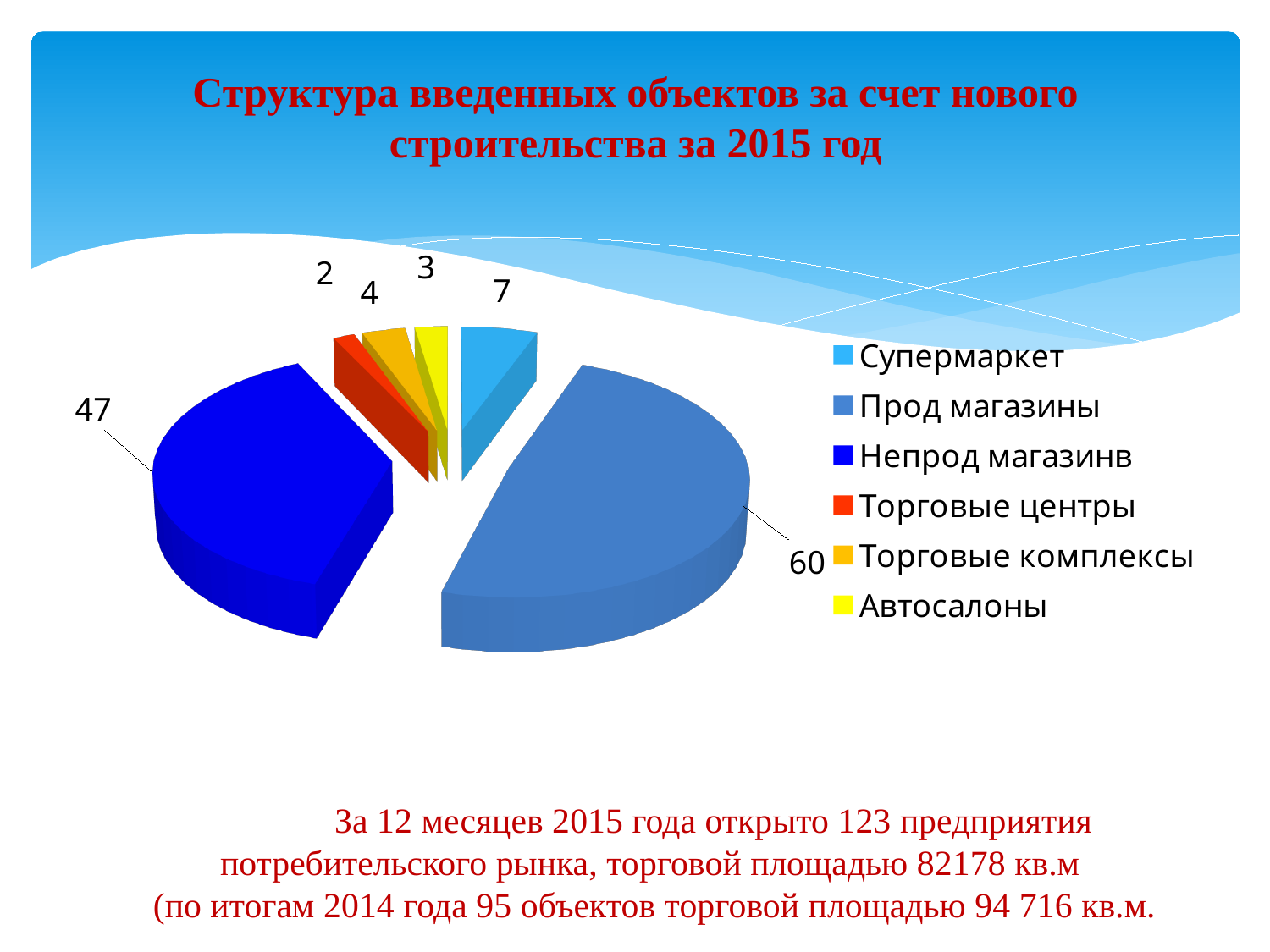
What type of chart is shown on the slide? Pie chart What is the value for Автосалоны in the pie chart? 3 Which is larger, the value for Торговые комплексы or the value for Автосалоны? Торговые комплексы What colour is the slice for Непрод магазинв in the pie chart? Dark blue What is the value for Прод магазины in the pie chart? 60 How many categories does the legend of the pie chart list? 6 What is the difference between the values for Прод магазины and Непрод магазинв? 13 What is the value for Торговые центры in the pie chart? 2 What is the value for Непрод магазинв in the pie chart? 47 What is the value for Супермаркет in the pie chart? 7 Which category has the largest slice in the pie chart? Прод магазины Which category has the smallest slice in the pie chart? Торговые центры